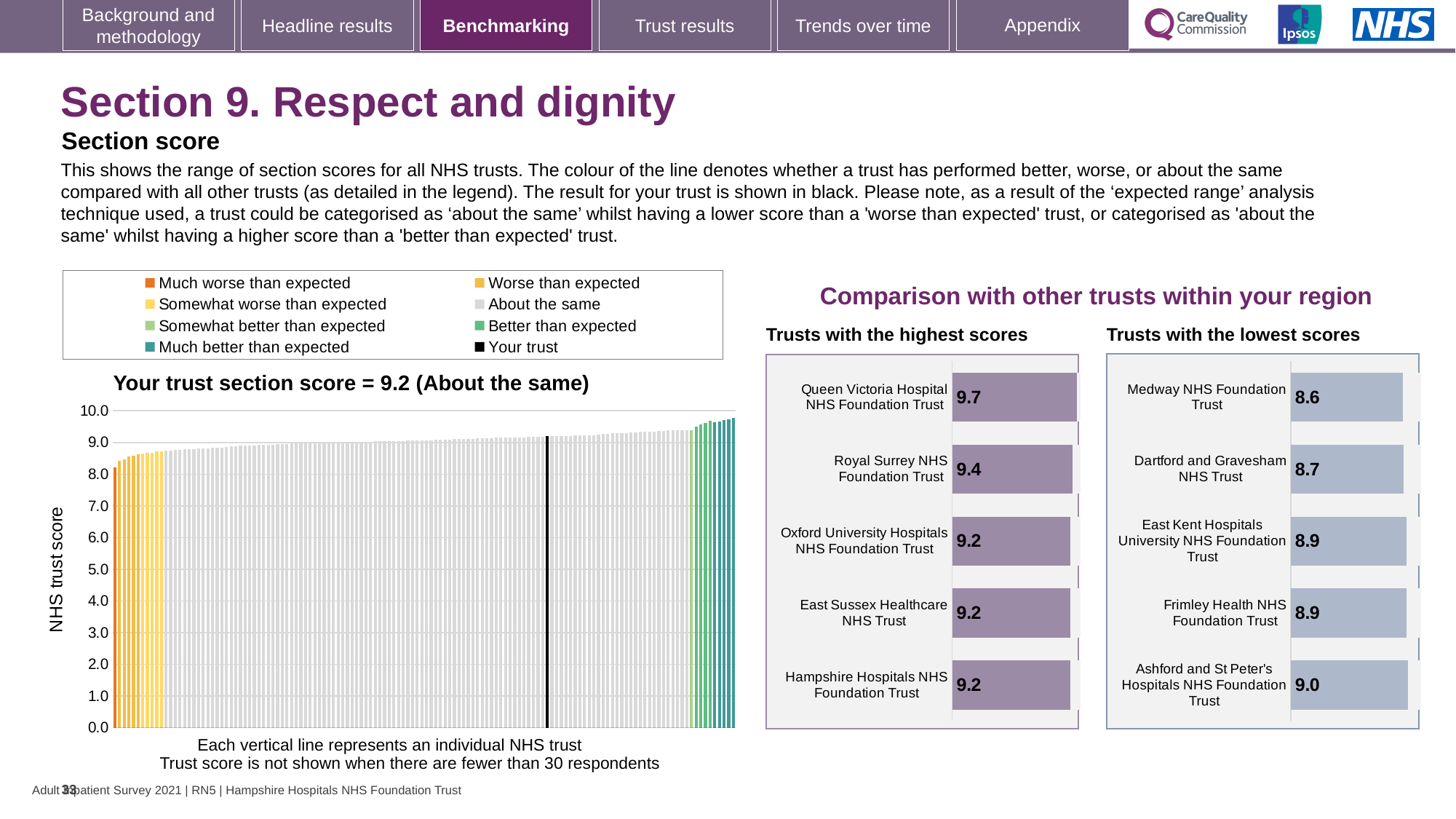
How many entries does the legend above the main chart on the left list? 8 According to the title of the main chart on the left, what is your trust's section score? 9.2 Which has the higher score: Royal Surrey NHS Foundation Trust in the highest scores chart or Dartford and Gravesham NHS Trust in the lowest scores chart? Royal Surrey NHS Foundation Trust In the 'Trusts with the highest scores' chart, which trust has the highest score? Queen Victoria Hospital NHS Foundation Trust How many trusts are shown in the 'Trusts with the lowest scores' chart? 5 In the 'Trusts with the lowest scores' chart, what is the score for Medway NHS Foundation Trust? 8.6 In the 'Trusts with the lowest scores' chart, what is the difference between the scores of Ashford and St Peter's Hospitals NHS Foundation Trust and Medway NHS Foundation Trust? 0.4 What kind of chart is the main chart on the left showing NHS trust scores? Bar chart In the 'Trusts with the lowest scores' chart, which trust has the lowest score? Medway NHS Foundation Trust In the 'Trusts with the highest scores' chart, what is the difference between the scores of Queen Victoria Hospital NHS Foundation Trust and Royal Surrey NHS Foundation Trust? 0.3 In the 'Trusts with the highest scores' chart, what is the score for Queen Victoria Hospital NHS Foundation Trust? 9.7 How many trusts are shown in the 'Trusts with the highest scores' chart? 5